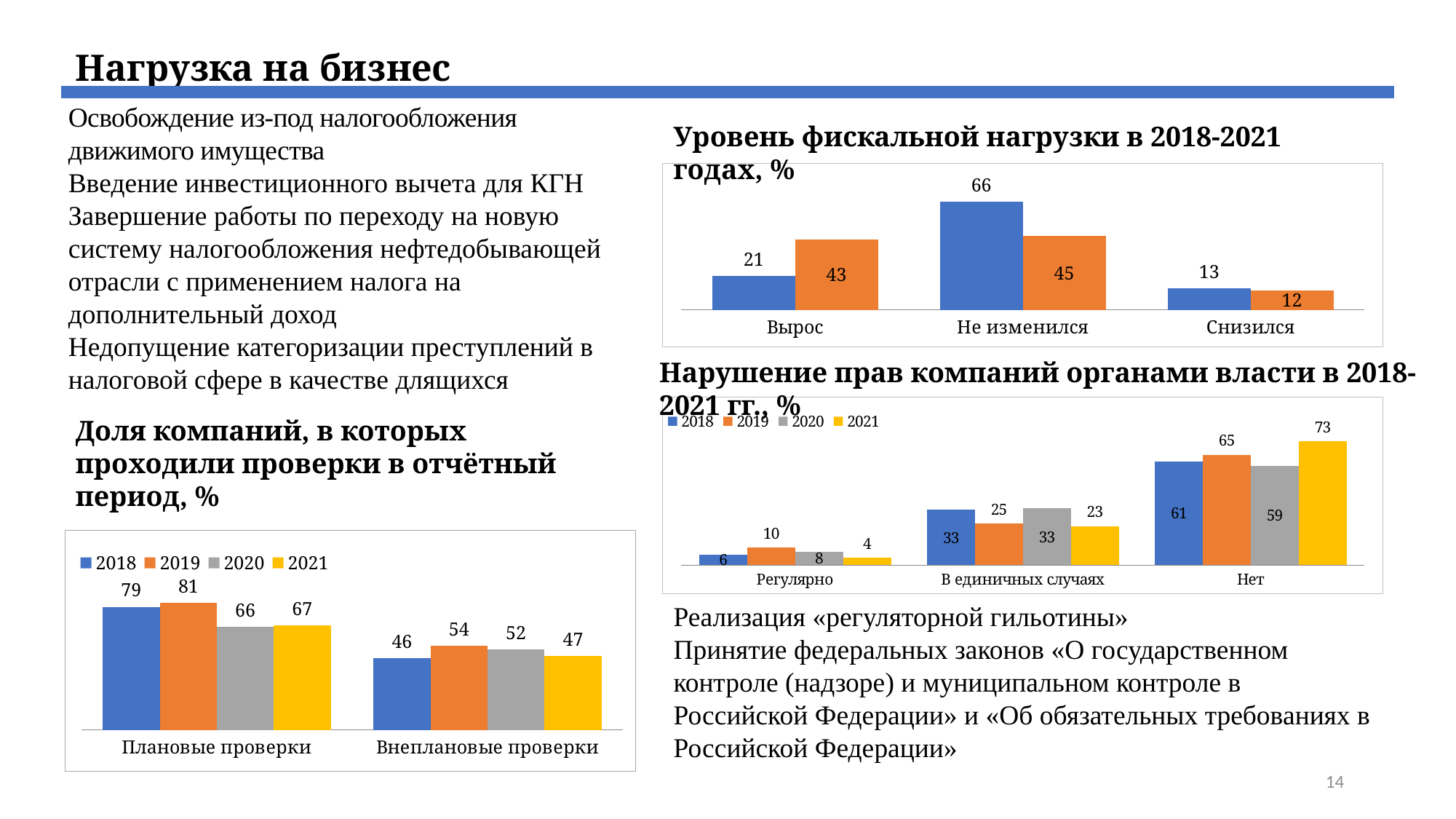
In the chart 'Доля компаний, в которых проходили проверки в отчётный период, %', what is the difference between the 2018 values for 'Плановые проверки' and 'Внеплановые проверки'? 33 What type of chart is 'Уровень фискальной нагрузки в 2018-2021 годах, %'? bar chart In the chart 'Уровень фискальной нагрузки в 2018-2021 годах, %', what is the difference between the orange and blue bars for 'Вырос'? 22 In the chart 'Нарушение прав компаний органами власти в 2018-2021 гг., %', is the 2019 value for 'В единичных случаях' larger or smaller than the 2020 value? smaller In the chart 'Нарушение прав компаний органами власти в 2018-2021 гг., %', which year has the lowest value in the 'Регулярно' category? 2021 In the chart 'Нарушение прав компаний органами власти в 2018-2021 гг., %', what is the value for 2021 in the 'Нет' category? 73 In the chart 'Доля компаний, в которых проходили проверки в отчётный период, %', what is the value for 2021 in the 'Внеплановые проверки' category? 47 In the chart 'Нарушение прав компаний органами власти в 2018-2021 гг., %', how many categories are shown on the x axis? 3 In the chart 'Доля компаний, в которых проходили проверки в отчётный период, %', how many series does the legend list? 4 In the chart 'Доля компаний, в которых проходили проверки в отчётный период, %', what is the value for 2019 in the 'Плановые проверки' category? 81 In the chart 'Уровень фискальной нагрузки в 2018-2021 годах, %', what is the value of the blue bar for 'Не изменился'? 66 In the chart 'Нарушение прав компаний органами власти в 2018-2021 гг., %', which year has the highest value in the 'Нет' category? 2021